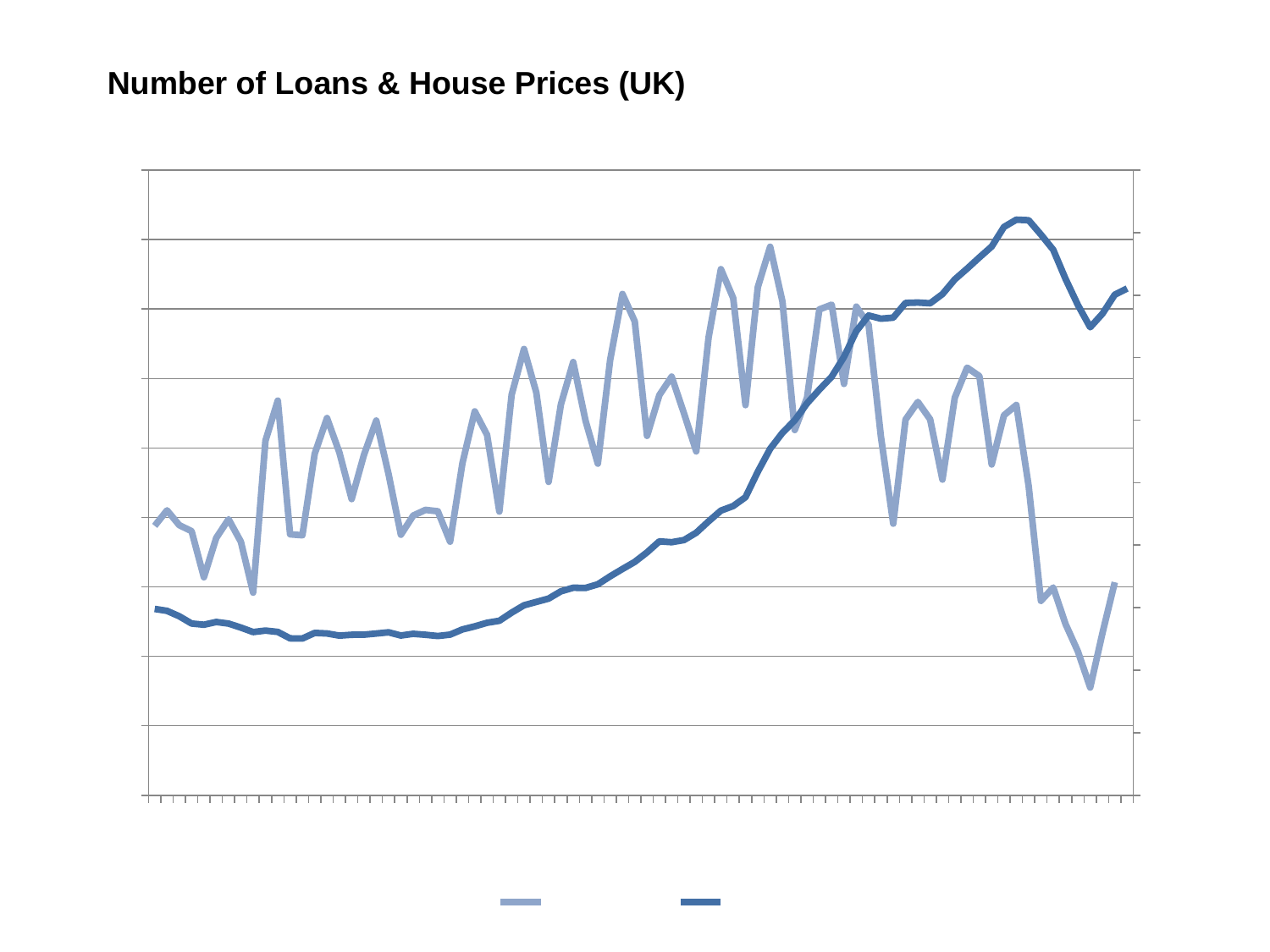
How many series does the legend list? 2 Which line reaches the highest point on the chart, the dark blue line or the light blue line? Dark blue line At the left-hand end of the chart, which line is higher, the dark blue line or the light blue line? Light blue line What kind of chart is shown on the slide? Line chart What is the title of the chart? Number of Loans & House Prices (UK) Does the light blue line rise or fall sharply near the right-hand end of the chart? Fall At the right-hand end of the chart, which line is higher, the dark blue line or the light blue line? Dark blue line Does the dark blue line generally rise or fall from left to right across the chart? Rise